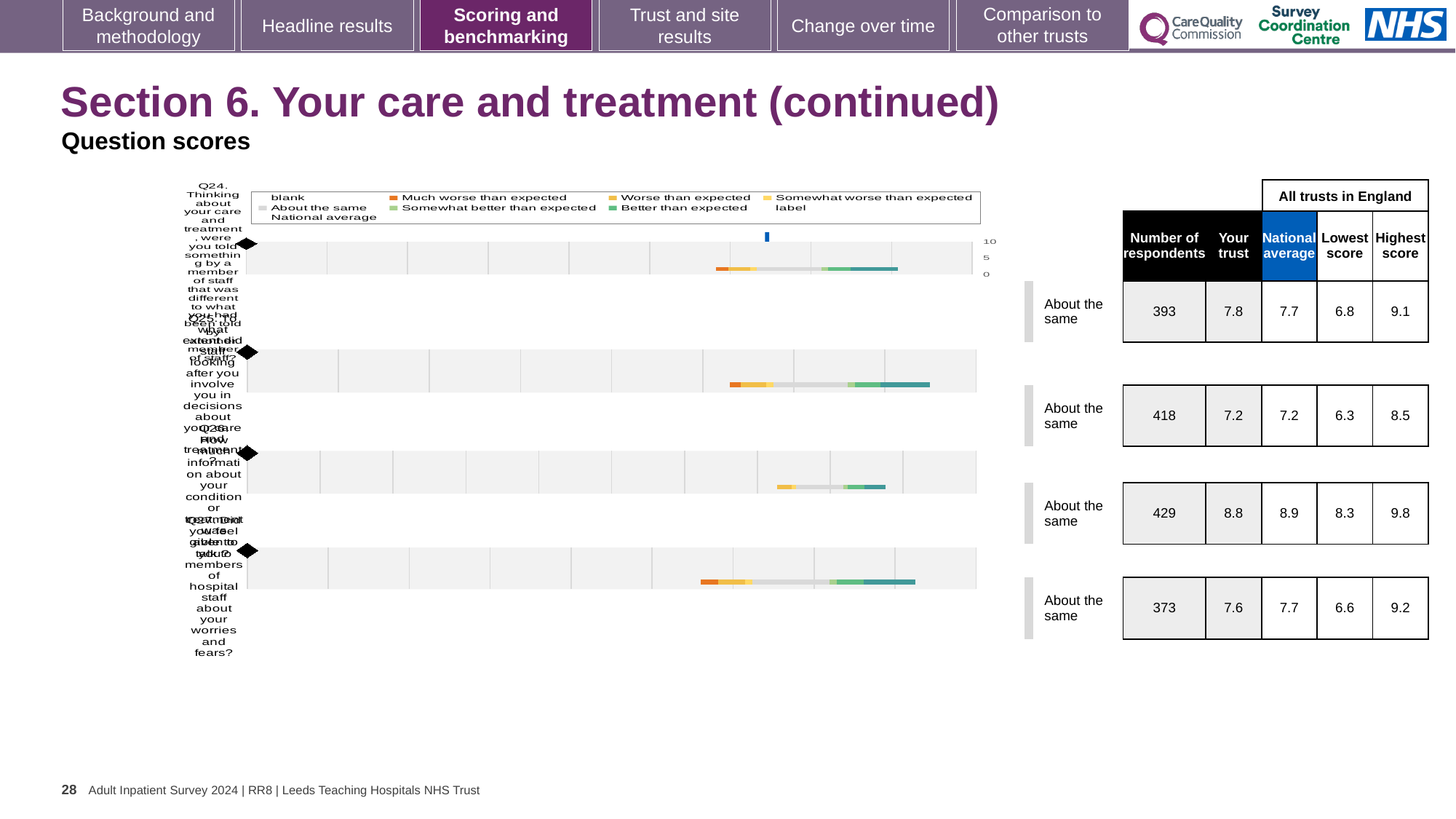
What is the highest value shown on the axis of the Q24 chart? 10 In the table row beside the Q24 chart, what is the 'Your trust' score? 7.8 How many benchmark charts are shown on the slide? 4 What kind of chart is used for the Q24 benchmark chart? bar chart Which legend entry is shown in orange in the chart legend? Much worse than expected In the table row beside the Q25 chart, what is the number of respondents? 418 Which question's row has the highest 'Your trust' score: Q24, Q25, Q26 or Q27? Q26 In the table row beside the Q26 chart, what is the national average? 8.9 What is the difference between the highest score and the lowest score in the row beside the Q25 chart? 2.2 Is the 'Your trust' score beside the Q24 chart larger or smaller than the national average in that row? larger Which question's row has the lowest 'Your trust' score: Q24, Q25, Q26 or Q27? Q25 In the table row beside the Q27 chart, what is the highest score among all trusts in England? 9.2